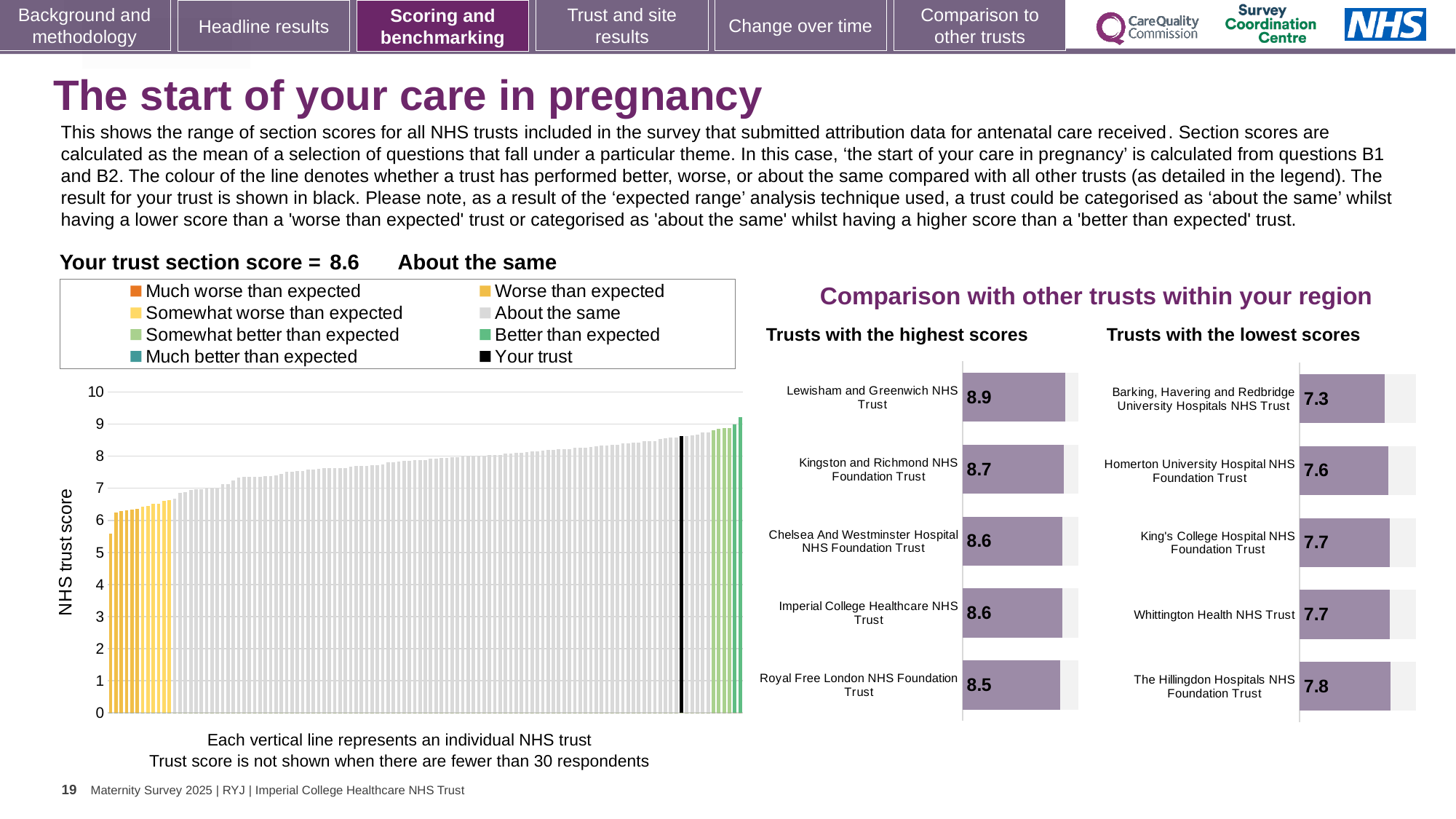
In the main 'NHS trust score' chart, do the values rise or fall from left to right? Rise How many entries does the legend of the main 'NHS trust score' chart list? 8 What kind of chart is the main 'NHS trust score' chart on the left? Bar chart In the 'Trusts with the lowest scores' chart, what is the difference between the scores of The Hillingdon Hospitals NHS Foundation Trust and Barking, Havering and Redbridge University Hospitals NHS Trust? 0.5 In the main 'NHS trust score' chart, what is the section score for your trust (the black bar)? 8.6 In the 'Trusts with the lowest scores' chart, what is the score for Barking, Havering and Redbridge University Hospitals NHS Trust? 7.3 Which has the higher score: Kingston and Richmond NHS Foundation Trust in the highest scores chart or Homerton University Hospital NHS Foundation Trust in the lowest scores chart? Kingston and Richmond NHS Foundation Trust In the 'Trusts with the highest scores' chart, what is the difference between the scores of Lewisham and Greenwich NHS Trust and Royal Free London NHS Foundation Trust? 0.4 In the 'Trusts with the highest scores' chart, what is the score for Lewisham and Greenwich NHS Trust? 8.9 How many trusts are shown in the 'Trusts with the highest scores' chart? 5 In the 'Trusts with the lowest scores' chart, which trust has the lowest score? Barking, Havering and Redbridge University Hospitals NHS Trust In the 'Trusts with the highest scores' chart, which trust has the highest score? Lewisham and Greenwich NHS Trust